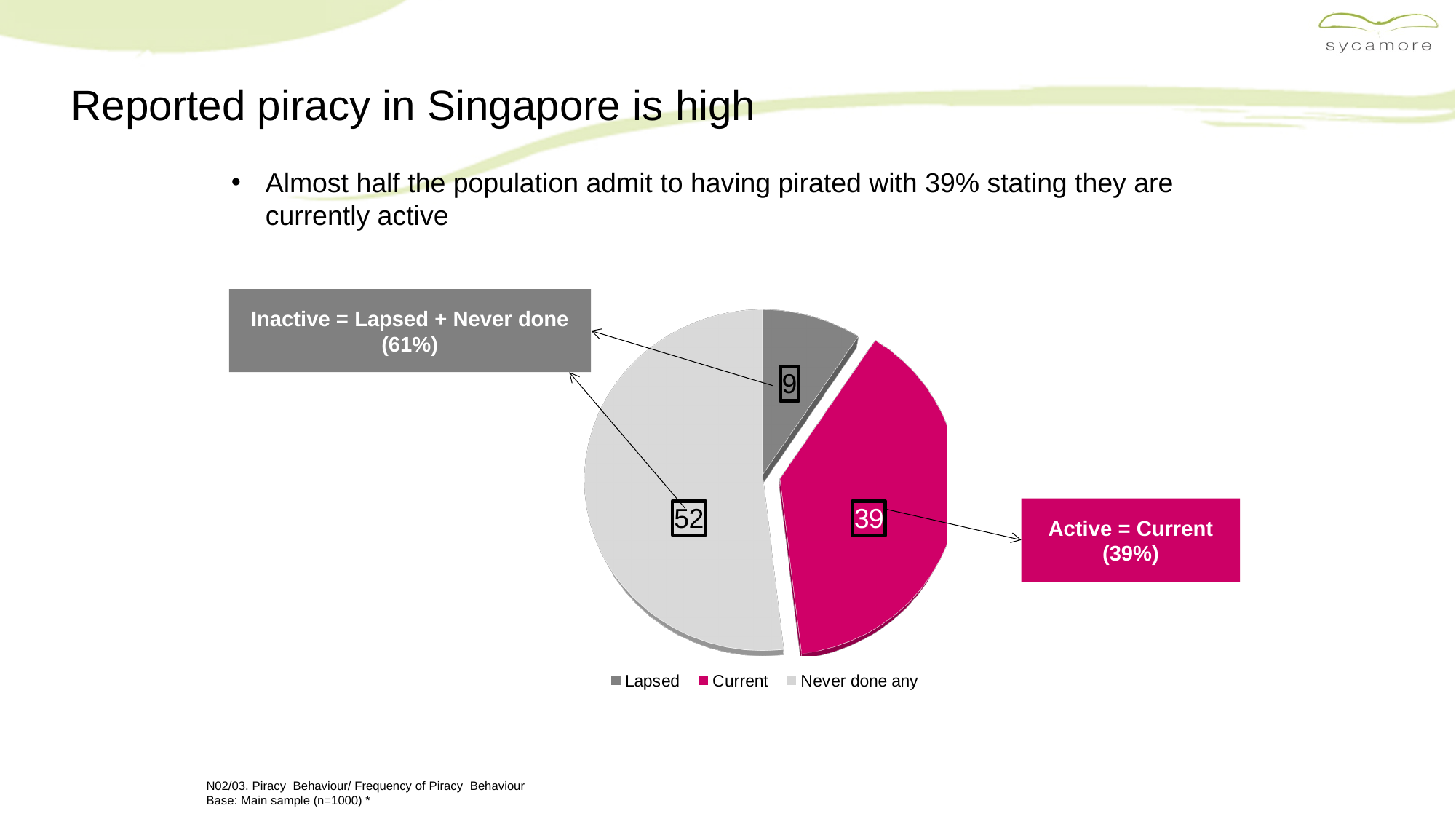
What kind of chart is shown on the slide? pie chart Which category has the smallest slice? Lapsed Which category has the largest slice? Never done any What is the value for the Lapsed slice? 9 What is the combined value of the Lapsed and Never done any slices? 61 What is the value for the Current slice? 39 What colour is the Current slice? magenta According to the callout box, what percentage is labelled Active = Current? 39% Which is larger, the Current slice or the Lapsed slice? Current What is the value for the Never done any slice? 52 What is the difference between the Never done any value and the Current value? 13 How many categories does the legend list? 3